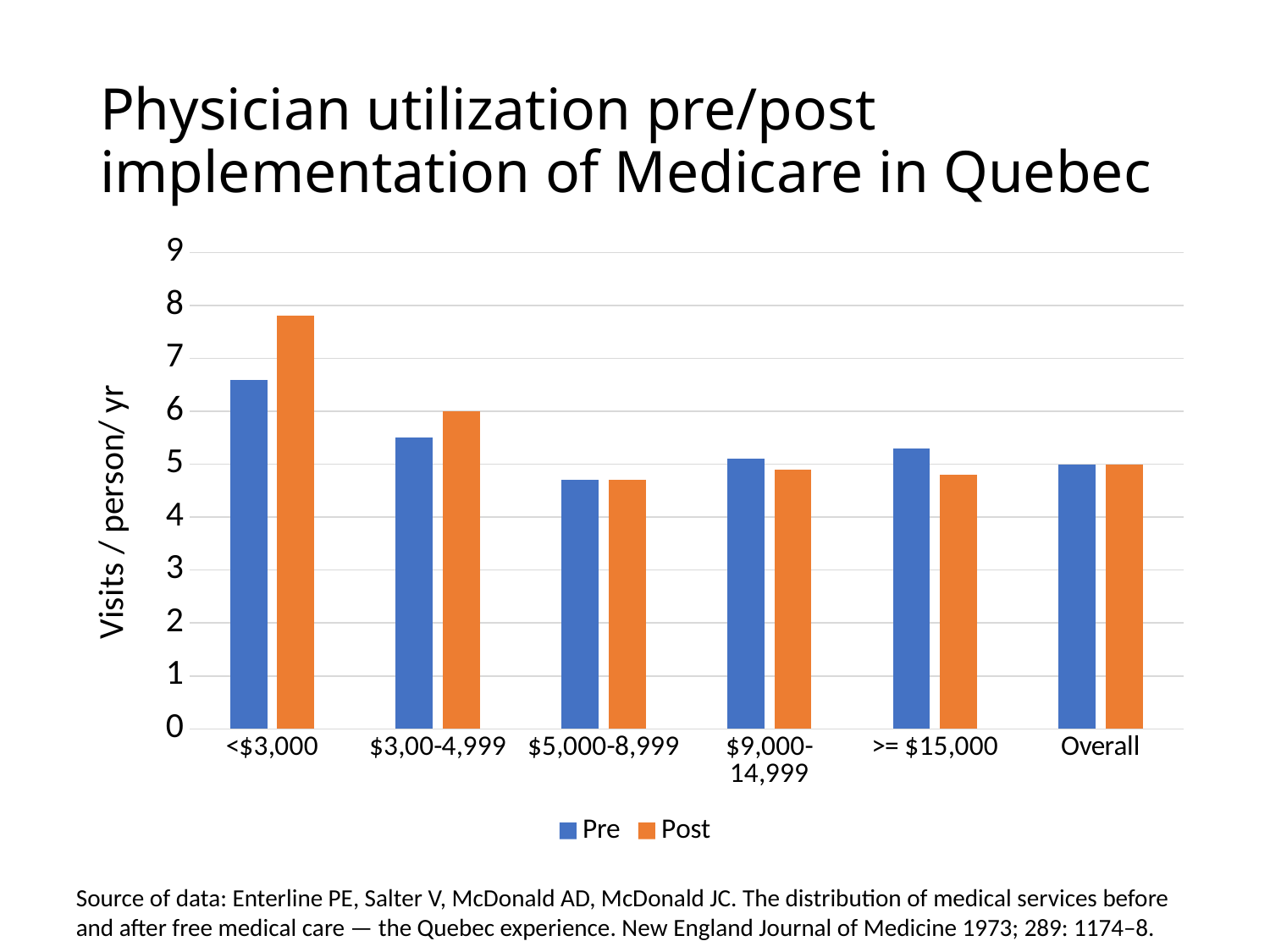
What kind of chart is shown on the slide? bar chart How many series does the legend list? 2 Is the Post value for <$3,000 greater or less than 7? greater For the <$3,000 category, which is larger, Pre or Post? Post Which income category has the highest Post value? <$3,000 Is the Pre value for $5,000-8,999 greater or less than 5? less Is the Pre value for <$3,000 greater or less than 6? greater What is the label of the y axis? Visits / person/ yr What are the two legend entries? Pre and Post Which income category has the lowest Pre value? $5,000-8,999 How many income categories are shown on the x axis? 6 For the >= $15,000 category, which is larger, Pre or Post? Pre